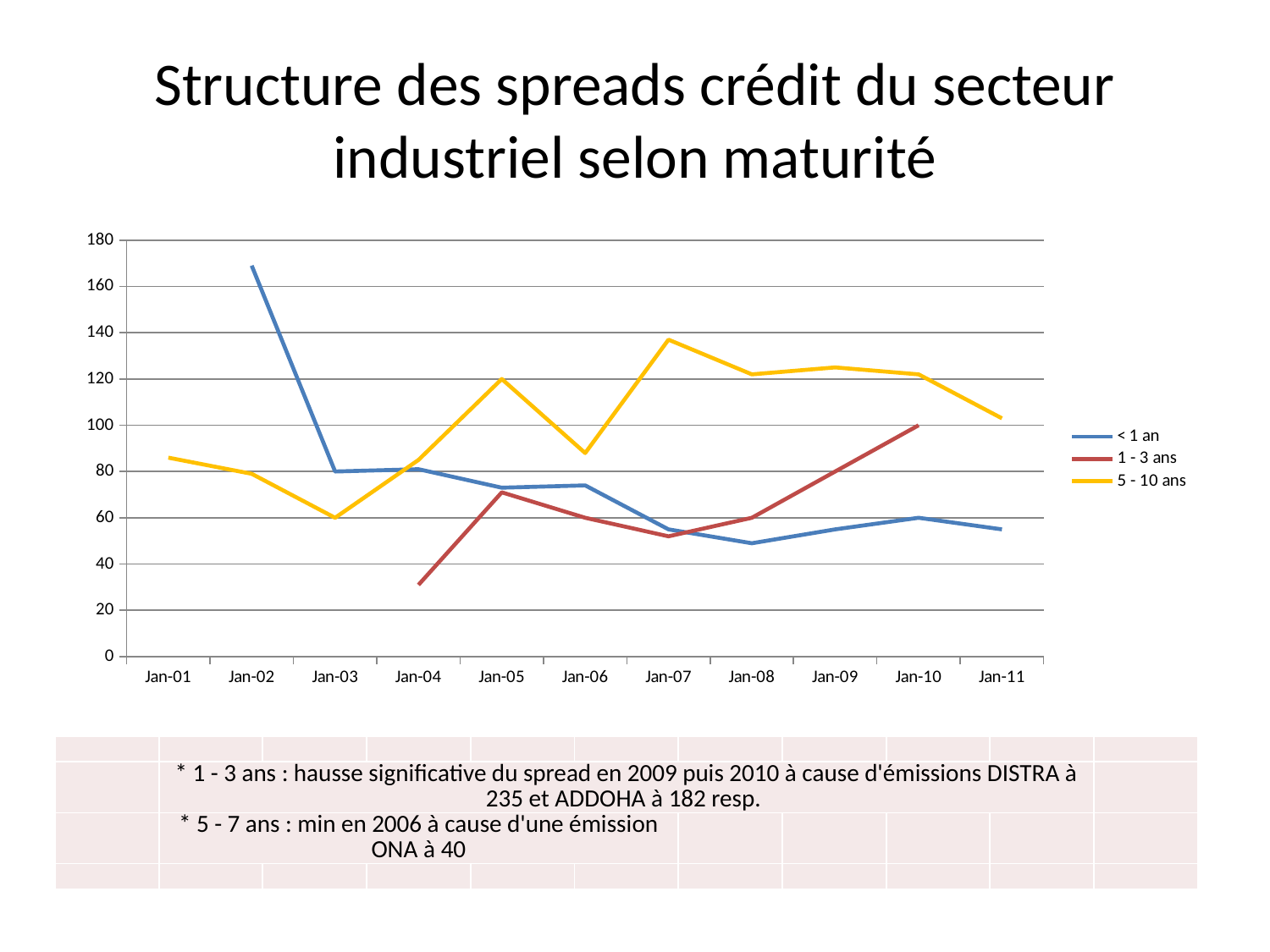
At which date does the '1 - 3 ans' series have its lowest value? Jan-04 How many dates are shown on the x axis? 11 Is the value for '< 1 an' at Jan-02 greater or less than 160? greater Is the value for '5 - 10 ans' at Jan-07 greater or less than 120? greater What kind of chart is shown on the slide? line chart At which date does the '5 - 10 ans' series reach its highest value? Jan-07 How many series does the legend list? 3 Does the '< 1 an' series rise or fall between Jan-02 and Jan-03? fall Which series is drawn in yellow? 5 - 10 ans Is the value for '1 - 3 ans' at Jan-04 greater or less than 40? less At Jan-10, which series has the larger value: '1 - 3 ans' or '< 1 an'? 1 - 3 ans At which date does the '< 1 an' series reach its highest value? Jan-02